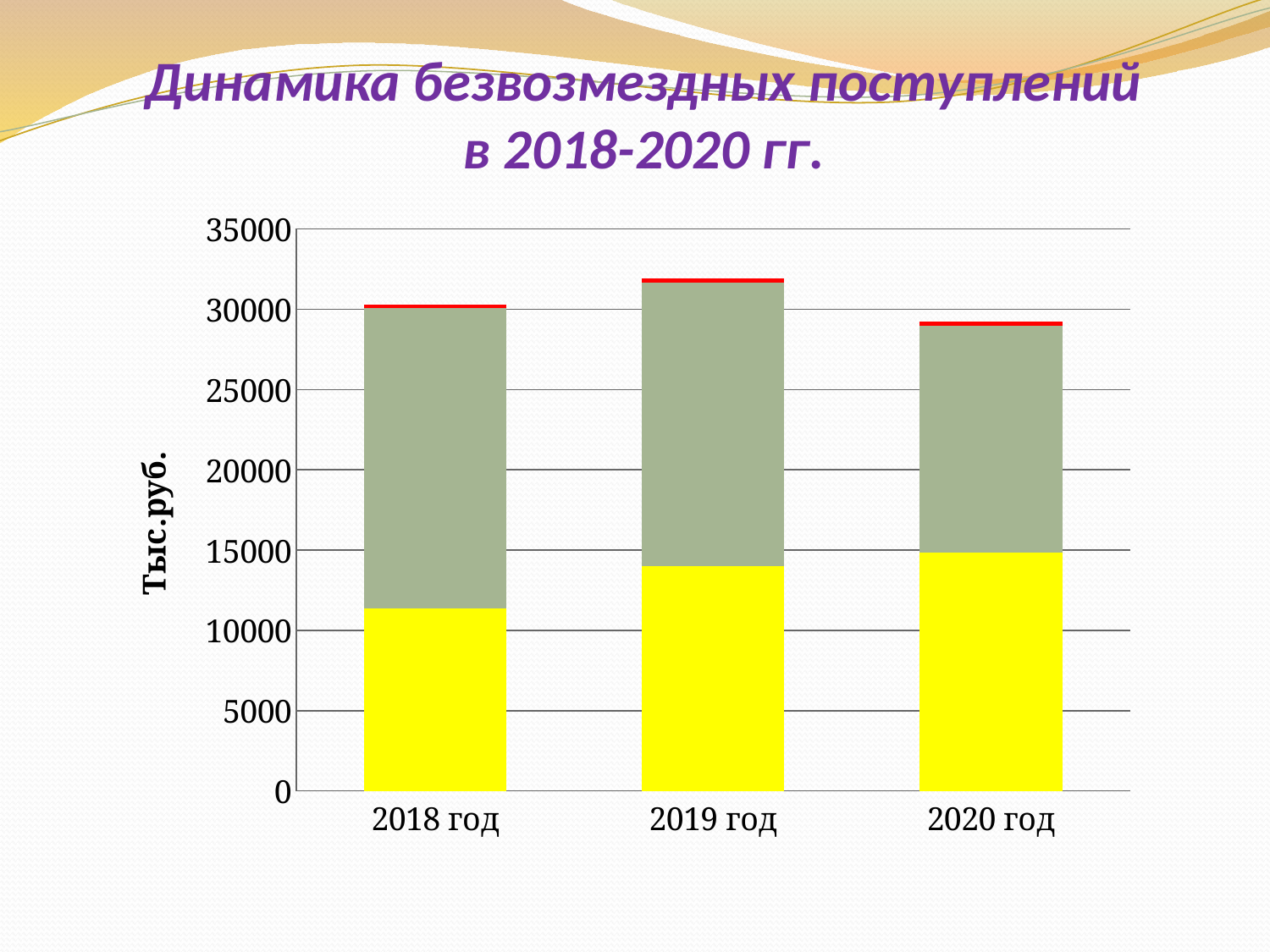
Does the total bar height rise or fall from 2019 год to 2020 год? fall Which year has the smallest yellow segment? 2018 год What is the title of the slide? Динамика безвозмездных поступлений в 2018-2020 гг. What kind of chart is shown on the slide? stacked bar chart Which year has the shortest stacked bar overall? 2020 год Is the total height of the bar for 2020 год greater or less than 30000? less Is the total height of the bar for 2019 год greater or less than 30000? greater How many years (categories) are shown on the x axis? 3 Is the yellow segment for 2018 год greater or less than 10000? greater Which year has the tallest stacked bar overall? 2019 год What is the label on the vertical axis? Тыс.руб.